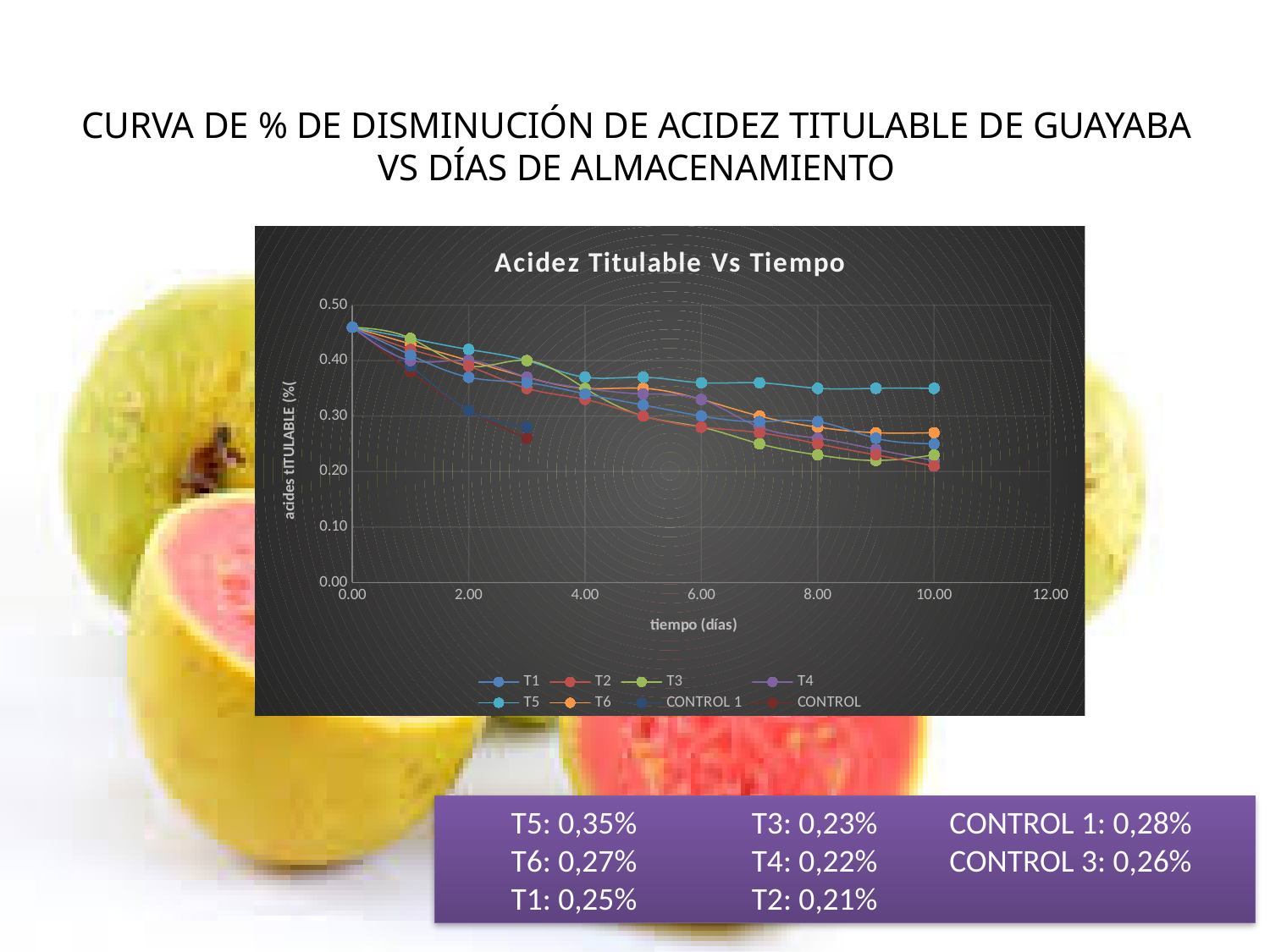
What is the x-axis title of the chart? tiempo (días) What is the title of the chart? Acidez Titulable Vs Tiempo Do the values of the T1 series rise or fall as time increases along the x axis? fall According to the text box below the chart, what is the value listed for T5? 0,35% What kind of chart is shown on the slide? line chart At day 10.00, which series has the larger value, T5 or T3? T5 According to the text box below the chart, what is the value listed for CONTROL 1? 0,28% Is the value for T2 at day 10.00 greater or less than 0.30? less Which series has the highest value at day 10.00? T5 According to the text box below the chart, what is the value listed for T2? 0,21% Is the value for T5 at day 10.00 greater or less than 0.30? greater How many series does the legend of the chart list? 8